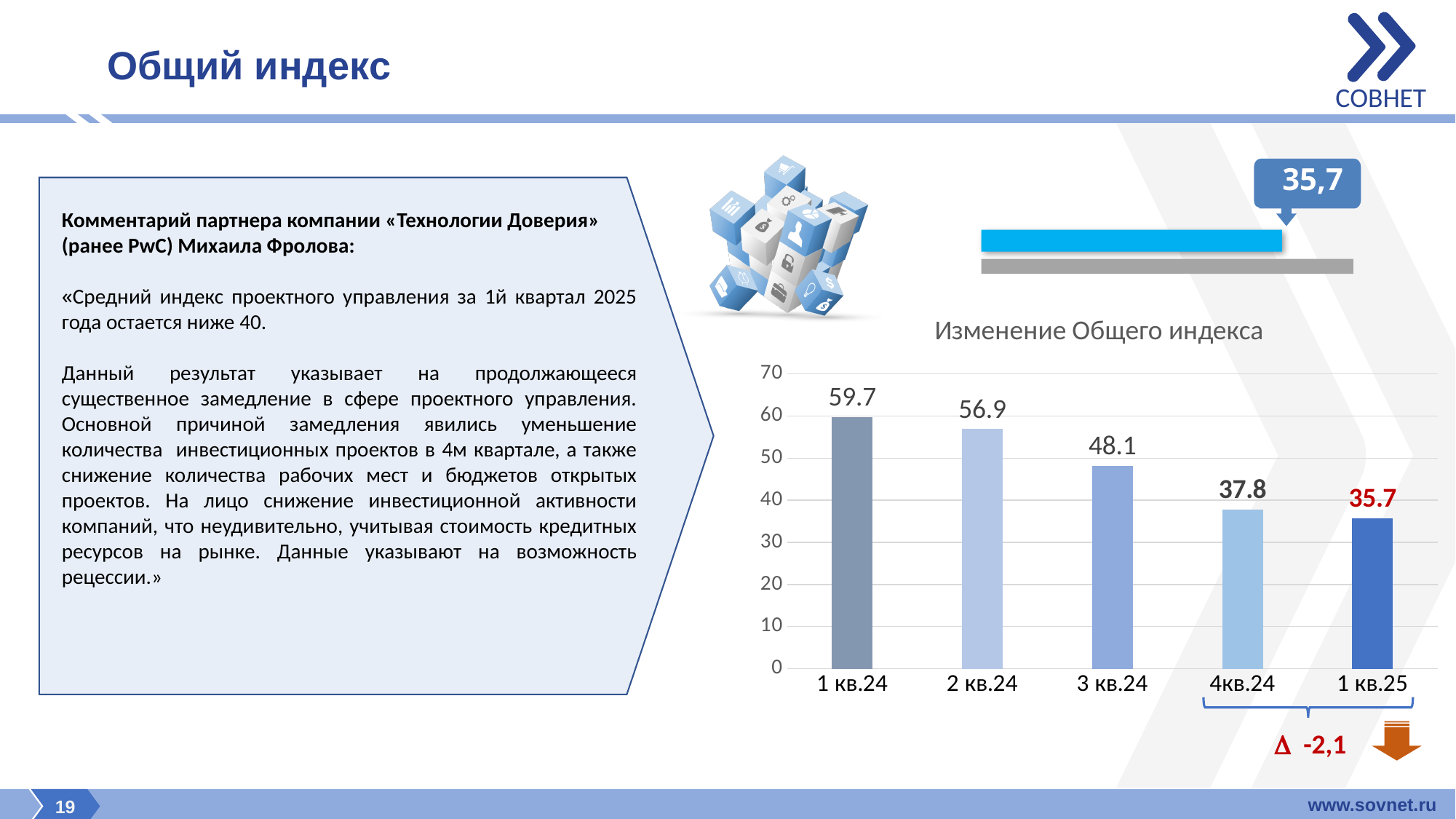
What is the value for 1 кв.24 in the chart 'Изменение Общего индекса'? 59.7 What kind of chart is 'Изменение Общего индекса'? bar chart Which quarter has the lowest value in the chart 'Изменение Общего индекса'? 1 кв.25 How many quarters are shown on the x axis of the chart 'Изменение Общего индекса'? 5 Which is larger in the chart 'Изменение Общего индекса': the value for 2 кв.24 or the value for 3 кв.24? 2 кв.24 What is the value for 3 кв.24 in the chart 'Изменение Общего индекса'? 48.1 Is the value for 4кв.24 in the chart 'Изменение Общего индекса' greater or less than 40? less What is the difference between the values for 4кв.24 and 1 кв.25 in the chart 'Изменение Общего индекса'? 2.1 What is the difference between the values for 1 кв.24 and 2 кв.24 in the chart 'Изменение Общего индекса'? 2.8 Which quarter has the highest value in the chart 'Изменение Общего индекса'? 1 кв.24 Do the values in the chart 'Изменение Общего индекса' rise or fall from 1 кв.24 to 1 кв.25? fall What is the value for 1 кв.25 in the chart 'Изменение Общего индекса'? 35.7